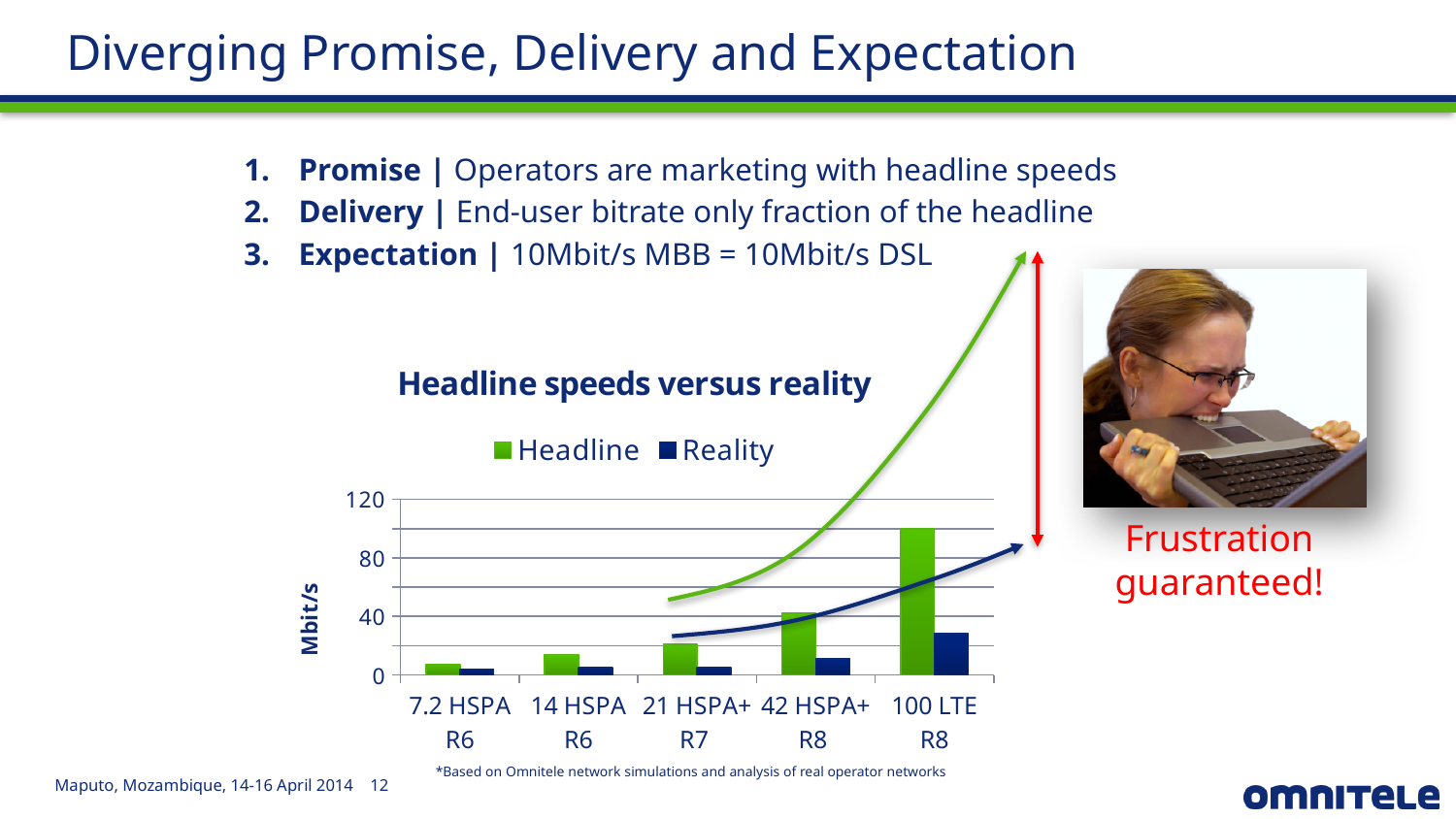
Which category has the highest Reality value in the "Headline speeds versus reality" chart? 100 LTE R8 Which category has the highest Headline value in the "Headline speeds versus reality" chart? 100 LTE R8 Is the Headline value for 100 LTE R8 greater or less than 80? greater Do the Headline values rise or fall moving from 7.2 HSPA R6 to 100 LTE R8 along the x axis? rise How many technology categories are shown on the x axis of the "Headline speeds versus reality" chart? 5 What is the label on the vertical axis of the "Headline speeds versus reality" chart? Mbit/s Is the Headline value for 21 HSPA+ R7 greater or less than 40? less Is the Reality value for 100 LTE R8 greater or less than 40? less How many series does the legend of the "Headline speeds versus reality" chart list? 2 What type of chart is shown under the title "Headline speeds versus reality"? Bar chart For 100 LTE R8, which is larger: the Headline value or the Reality value? Headline Which category has the lowest Headline value in the "Headline speeds versus reality" chart? 7.2 HSPA R6